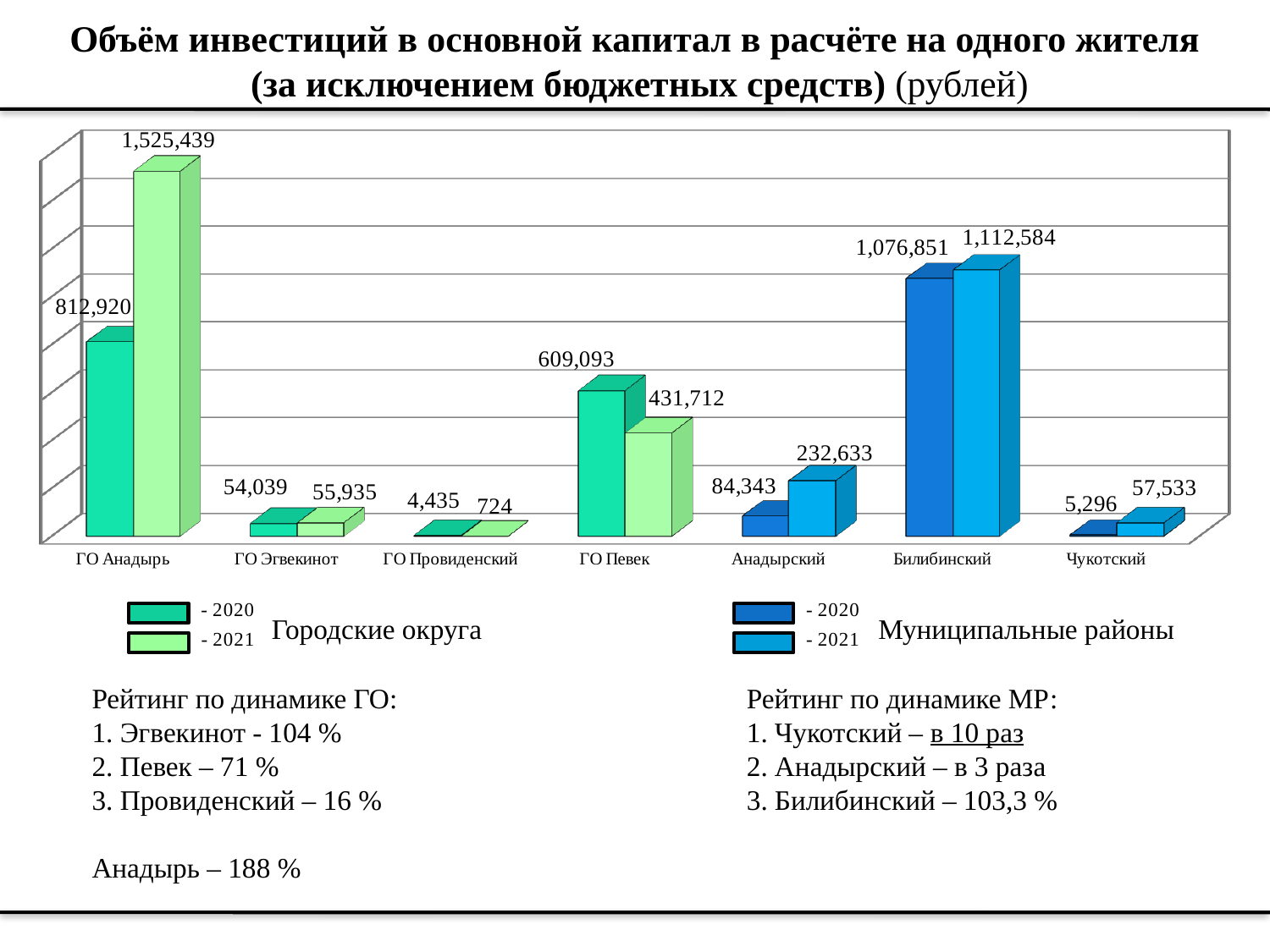
Which category has the lowest 2021 value? ГО Провиденский What is the 2020 value for ГО Певек? 609,093 What is the difference between the 2020 and 2021 values for ГО Певек? 177,381 Which category has the highest 2021 value? ГО Анадырь What is the 2020 value for Билибинский? 1,076,851 What kind of chart is shown on the slide? Bar chart How many categories are shown on the x axis? 7 Which is larger: the 2020 value for ГО Певек or the 2021 value for Анадырский? 2020 value for ГО Певек What is the difference between the 2021 and 2020 values for ГО Анадырь? 712,519 Which category has the highest 2020 value? Билибинский What is the 2021 value for ГО Анадырь? 1,525,439 What is the 2021 value for Чукотский? 57,533